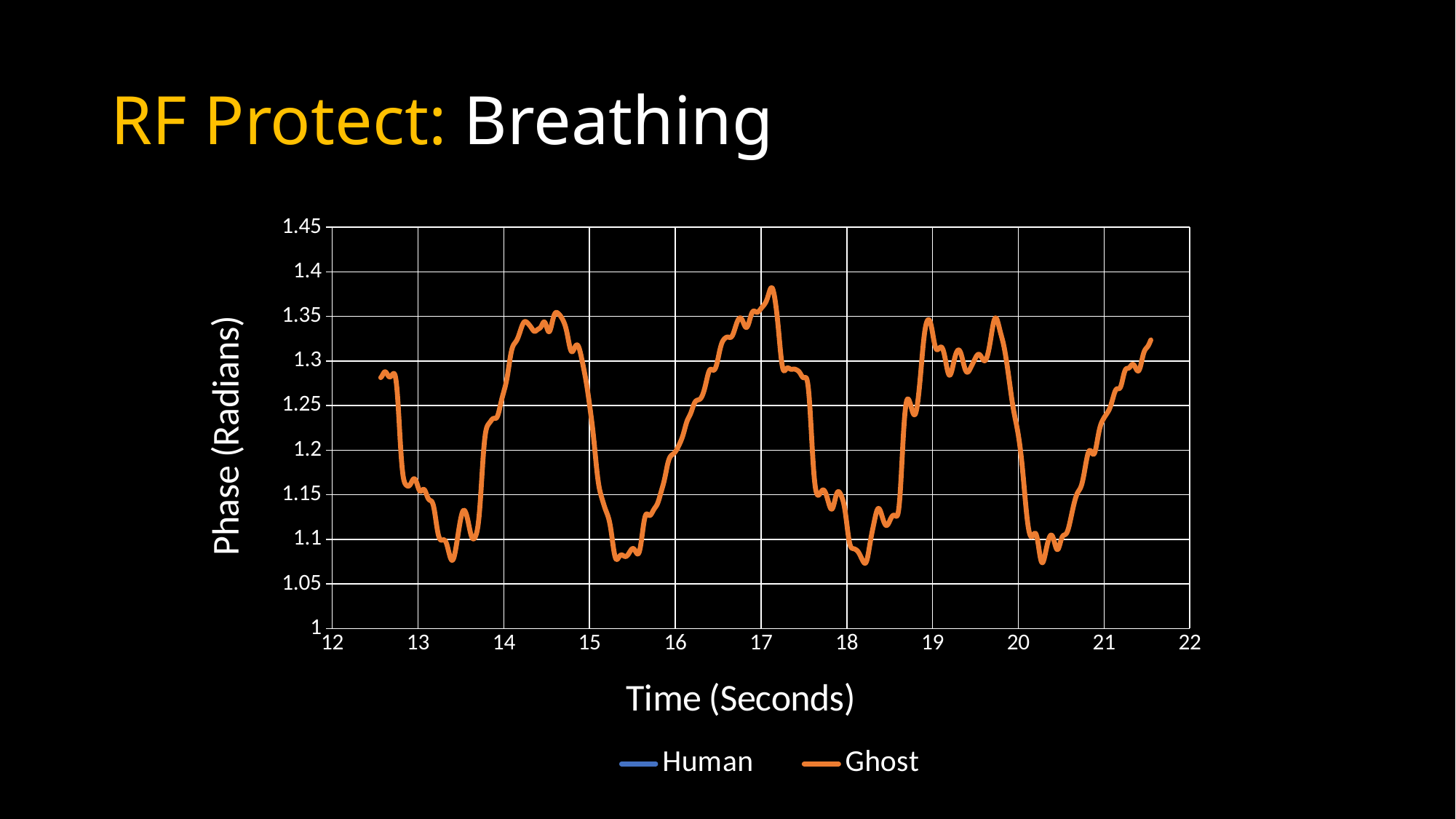
Is the value of the Ghost series at 19 seconds greater or less than 1.3? greater Is the value of the Ghost series at 18 seconds greater or less than 1.2? less Is the value of the Ghost series at 13 seconds greater or less than 1.2? less How many series does the legend list? 2 What is the label of the vertical axis? Phase (Radians) What kind of chart is shown on the slide? Line chart Does the Ghost series rise or fall between 17 and 18 seconds? fall What are the two series named in the legend? Human and Ghost Does the Ghost series rise or fall between 16 and 17 seconds? rise